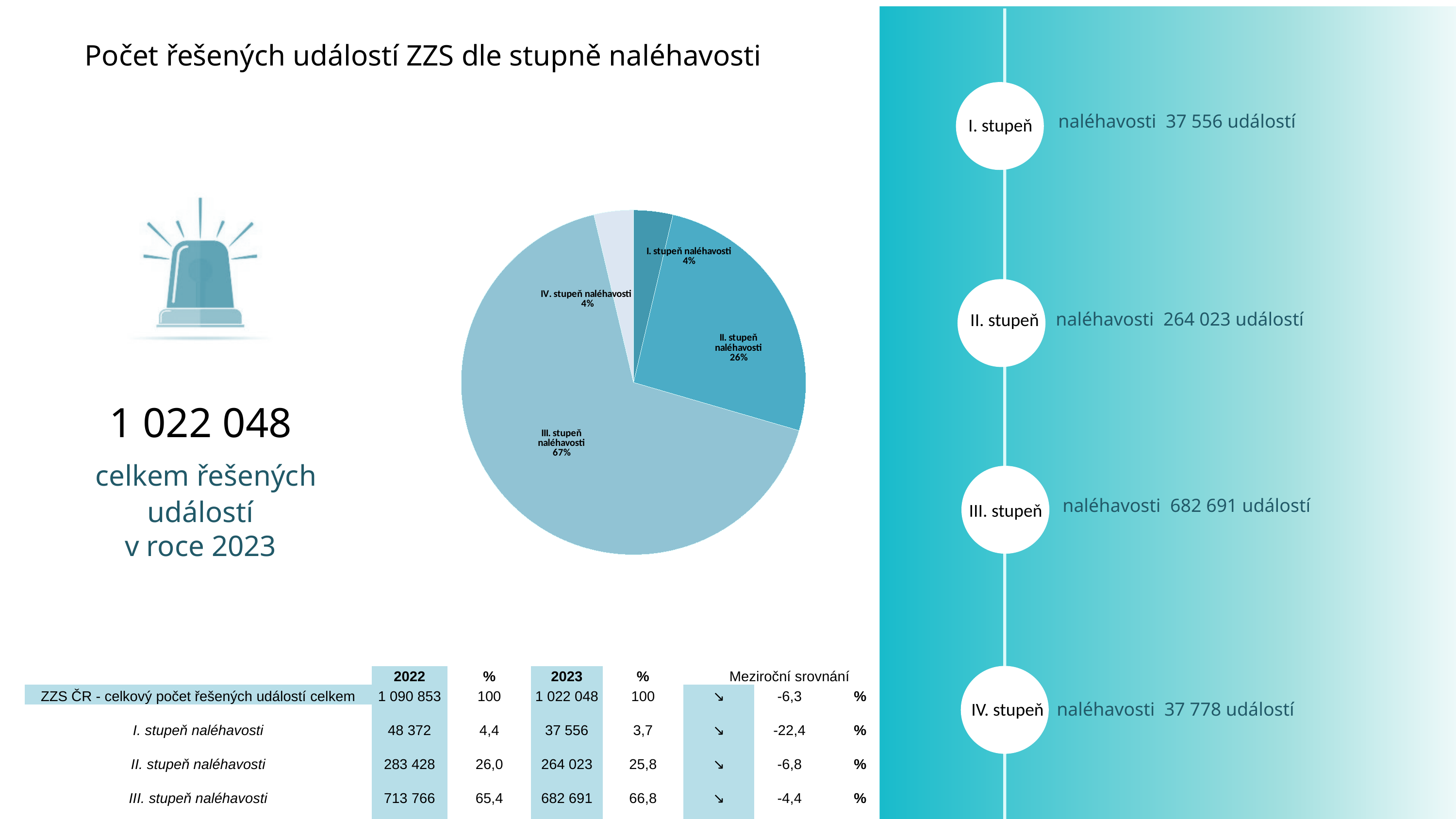
What kind of chart is shown on the slide? pie chart How many slices does the pie chart have? 4 Which slice of the pie chart is the darkest in colour? I. stupeň naléhavosti What is the difference in percentage points between the III. stupeň naléhavosti slice and the II. stupeň naléhavosti slice? 41 What is the difference in percentage points between the II. stupeň naléhavosti slice and the I. stupeň naléhavosti slice? 22 What share of the pie does III. stupeň naléhavosti have? 67% Which slice of the pie chart is the largest? III. stupeň naléhavosti Is the share of II. stupeň naléhavosti in the pie chart greater or less than 50%? less What share of the pie does II. stupeň naléhavosti have? 26% What share of the pie does I. stupeň naléhavosti have? 4% Which is larger in the pie chart, II. stupeň naléhavosti or III. stupeň naléhavosti? III. stupeň naléhavosti